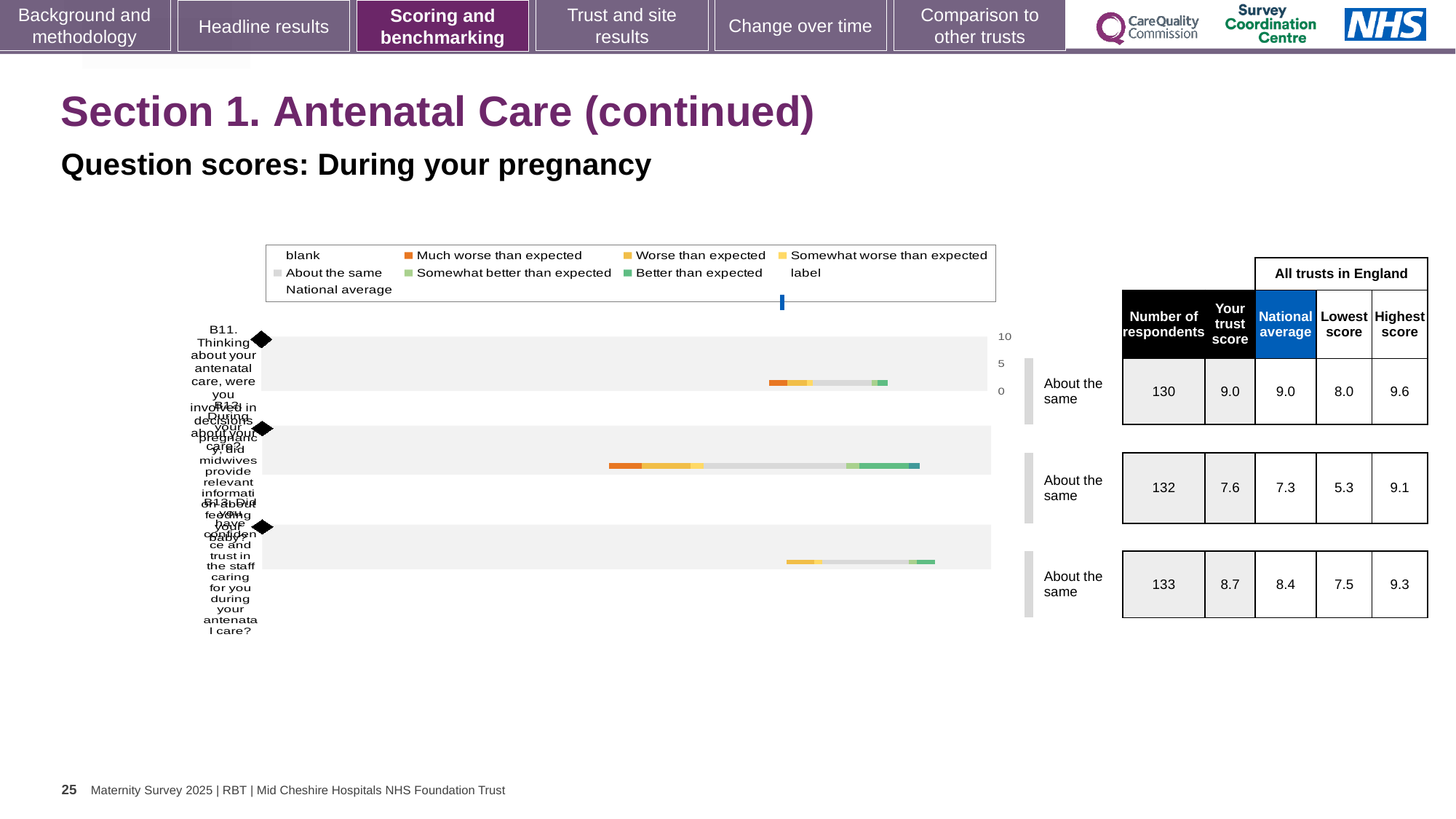
What benchmark label is shown next to the bar for question B11? About the same In the table beside the chart, what is the difference between the trust score and the national average for question B13? 0.3 What benchmark label is shown next to the bar for question B12? About the same In the table beside the chart, is the trust score for B12 larger or smaller than the national average for B12? larger In the table beside the chart, which question has the lowest 'Lowest score' across all trusts in England? B12 How many questions (bars) are plotted in the chart? 3 In the table beside the chart, what is the number of respondents for question B13? 133 What is the highest value shown on the chart's score axis? 10 In the table beside the chart, which question has the highest 'Highest score' across all trusts in England? B11 In the table beside the chart, what is the trust score for question B12? 7.6 What colour represents 'Much worse than expected' in the chart legend? orange What kind of chart is used to show the question scores on this slide? bar chart